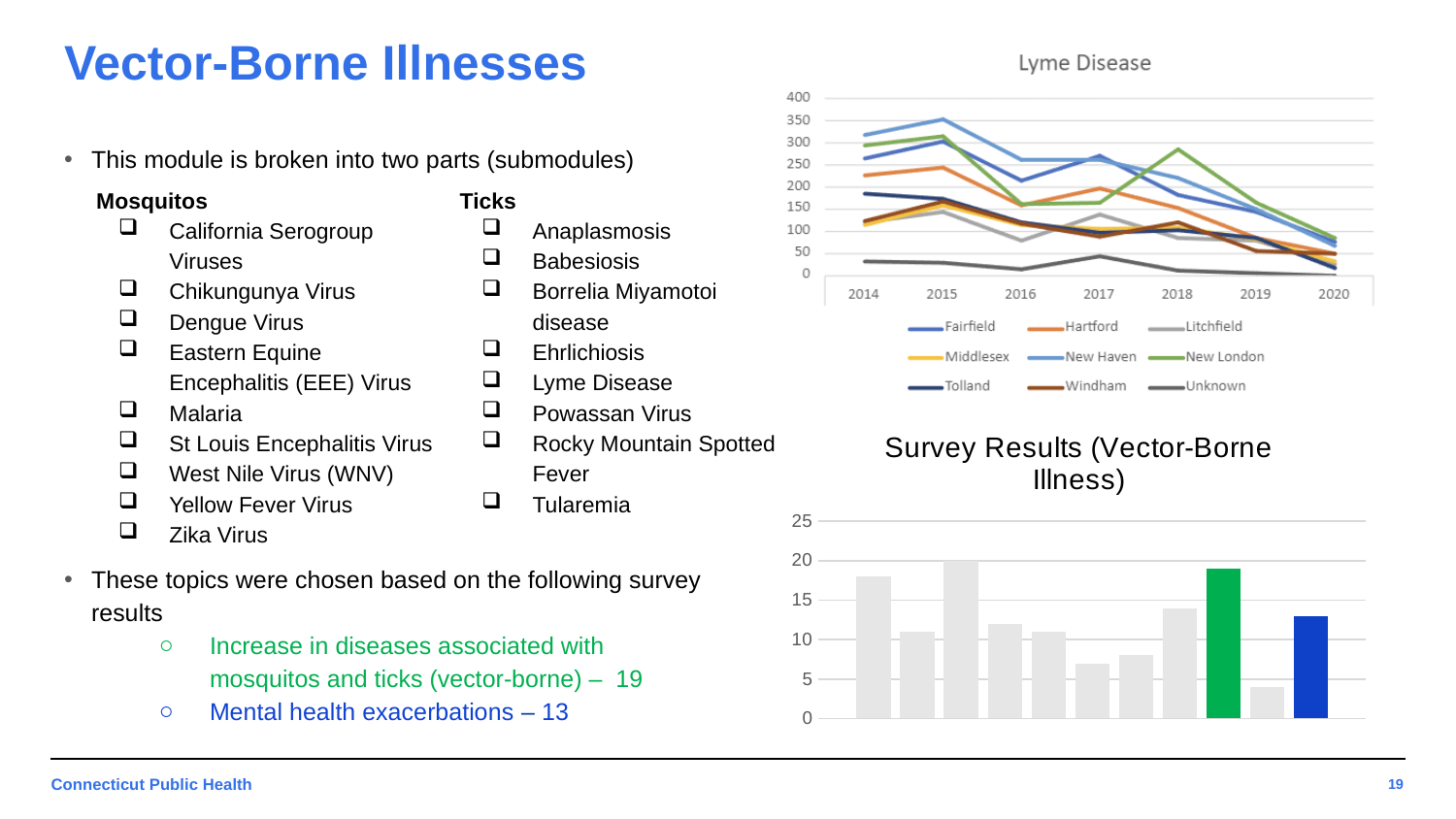
How many series does the legend of the Lyme Disease chart list? 9 In the Lyme Disease chart, is the value for Unknown in 2014 greater or less than 50? less In the Lyme Disease chart, which is larger in 2014: Fairfield or Unknown? Fairfield In the Lyme Disease chart, does the New Haven series rise or fall overall from 2014 to 2020? fall What type of chart is the Lyme Disease chart? line chart What type of chart is the Survey Results (Vector-Borne Illness) chart? bar chart In the Lyme Disease chart, which series has the highest value in 2015? New Haven How many years are shown on the x axis of the Lyme Disease chart? 7 How many bars are in the Survey Results (Vector-Borne Illness) chart? 11 In the Lyme Disease chart, is the value for New Haven in 2015 greater or less than 300? greater In the Survey Results (Vector-Borne Illness) chart, is the value of the green bar greater or less than 15? greater In the Lyme Disease chart, which series has the lowest value in 2014? Unknown